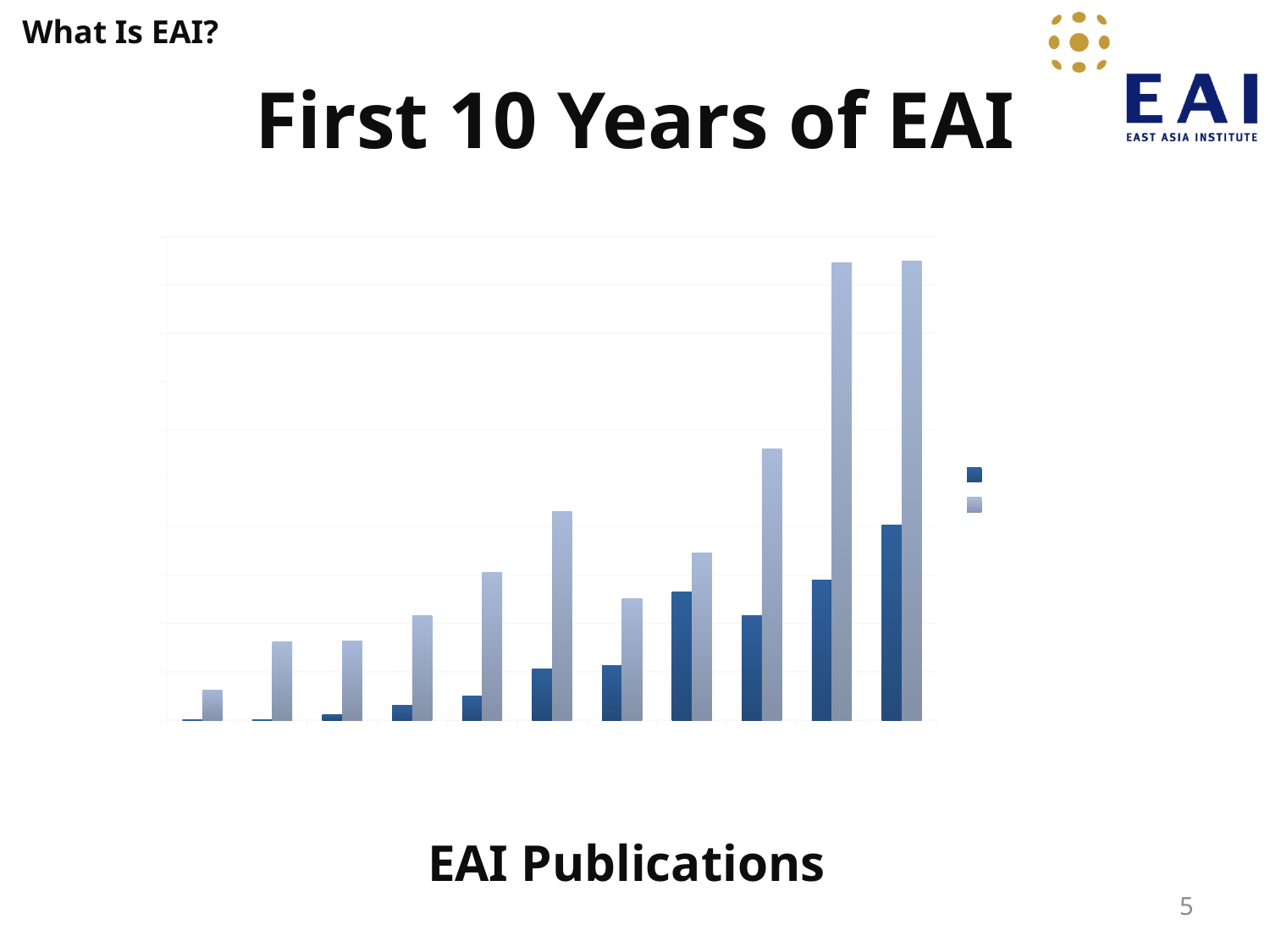
How many groups of bars (categories) are plotted along the x axis? 11 What two colours are used for the bars in the chart? dark blue and light blue Which series has the taller bar in every group, the dark blue series or the light blue series? light blue Do the values generally rise or fall from left to right along the x axis? rise In the rightmost group of bars, which bar is taller, the dark blue one or the light blue one? light blue What kind of chart is shown on the slide? bar chart How many series does the legend list? 2 What is the caption/title shown beneath the chart? EAI Publications